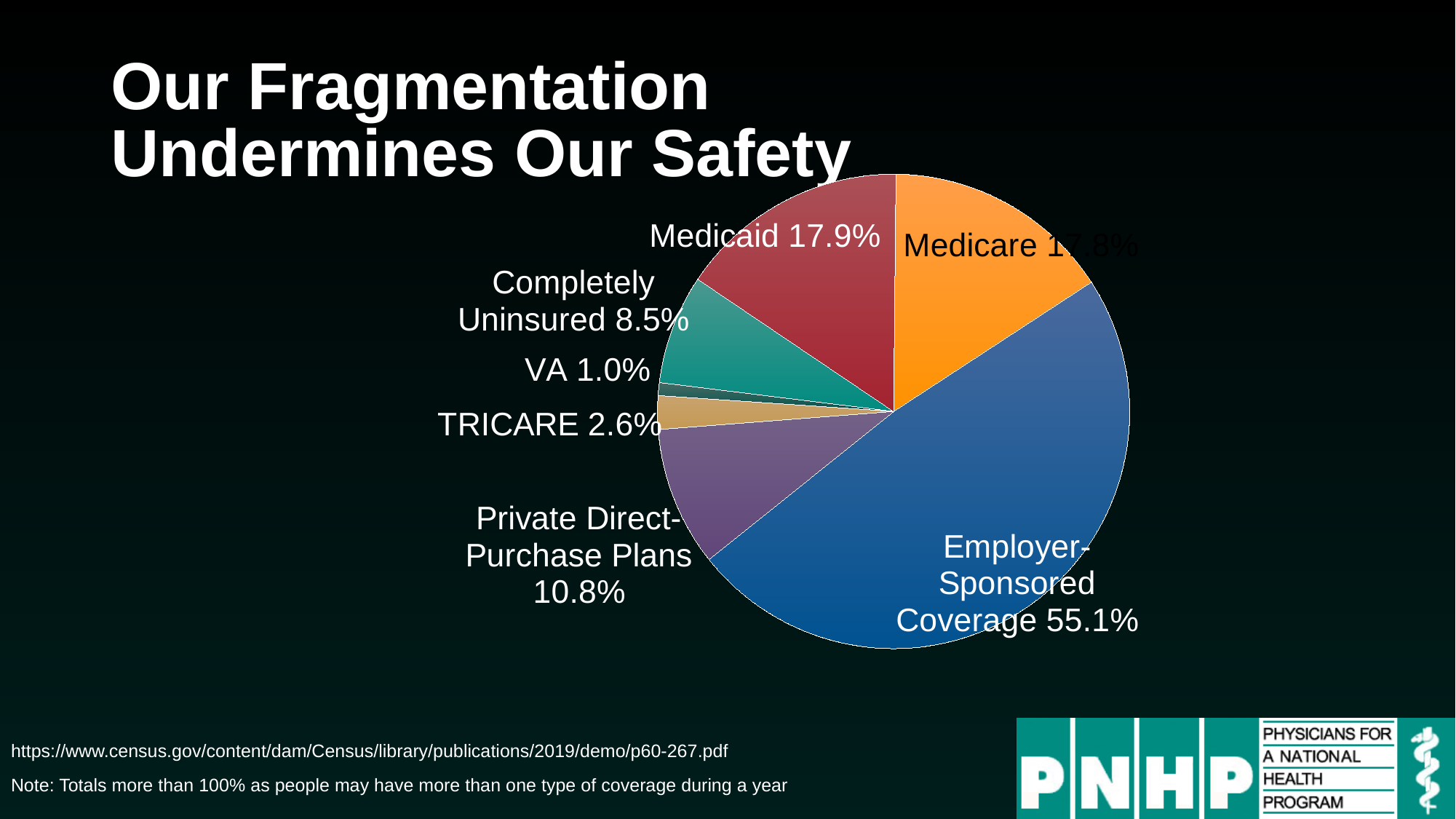
What percentage is shown for Completely Uninsured? 8.5% Which is larger, the TRICARE slice or the VA slice? TRICARE What kind of chart is shown on the slide? Pie chart What percentage is shown for TRICARE? 2.6% Which category has the largest slice of the pie? Employer-Sponsored Coverage How many slices does the pie chart have? 7 What share of the pie do Private Direct-Purchase Plans represent? 10.8% What percentage is shown for Medicaid? 17.9% What is the difference in percentage points between Private Direct-Purchase Plans and Completely Uninsured? 2.3 What percentage is shown for Employer-Sponsored Coverage? 55.1% Which category has the smallest slice of the pie? VA What percentage is shown for VA? 1.0%